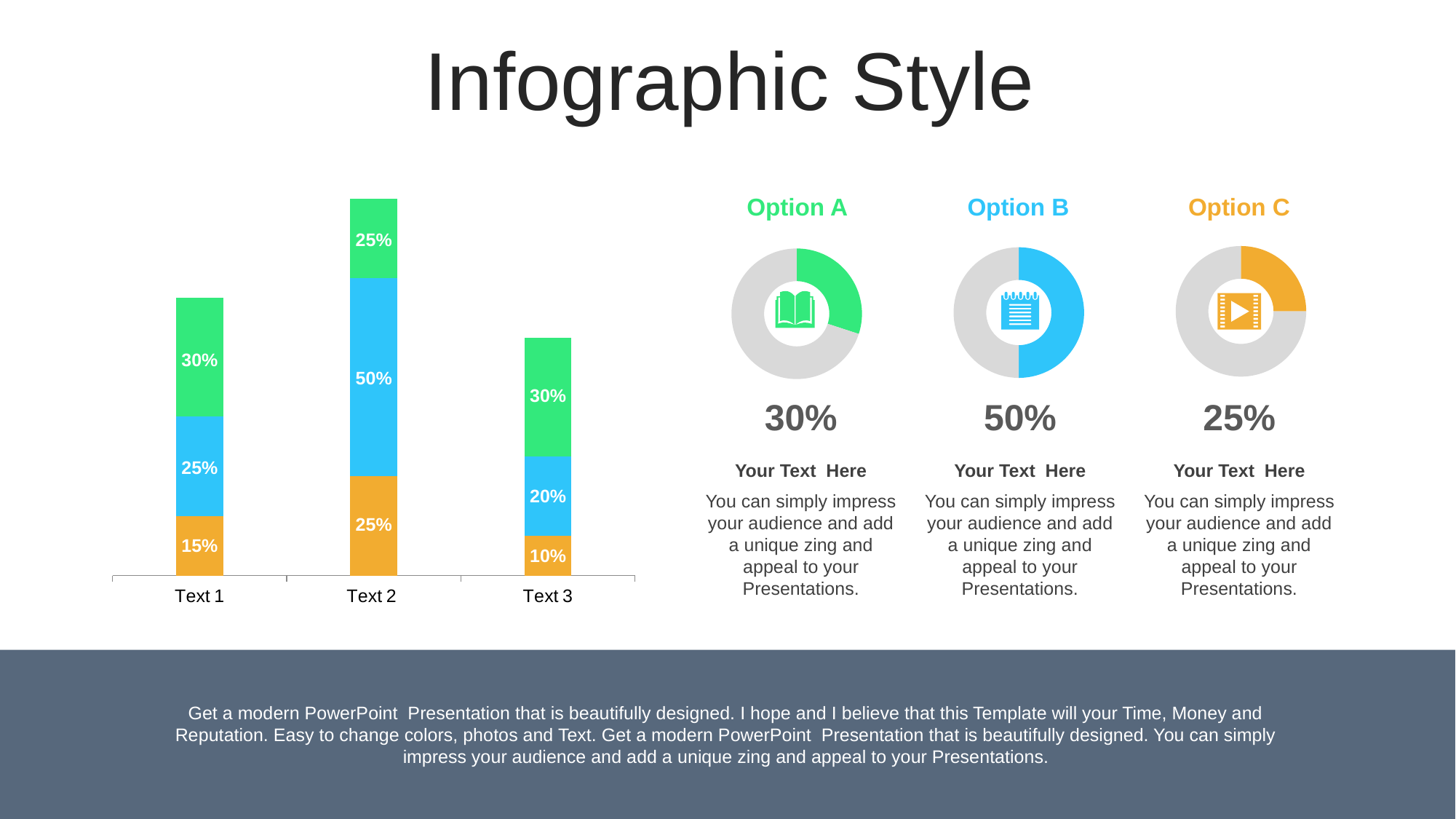
In the stacked bar chart, what is the total of the stacked bar for Text 3? 60% In the stacked bar chart, what is the value of the orange segment for Text 1? 15% In the stacked bar chart, how many categories are shown on the x axis? 3 What percentage is shown for the Option B donut chart? 50% In the stacked bar chart, which category has the shortest bar? Text 3 In the stacked bar chart, what is the value of the green segment for Text 3? 30% In the stacked bar chart, what is the difference between the blue segment of Text 2 and the blue segment of Text 3? 30% In the stacked bar chart, what is the total of the stacked bar for Text 1? 70% What kind of chart is shown on the left of the slide? Stacked bar chart In the stacked bar chart, is the orange segment larger for Text 2 or Text 3? Text 2 In the stacked bar chart, what is the value of the blue segment for Text 2? 50% In the stacked bar chart, which category has the tallest bar? Text 2